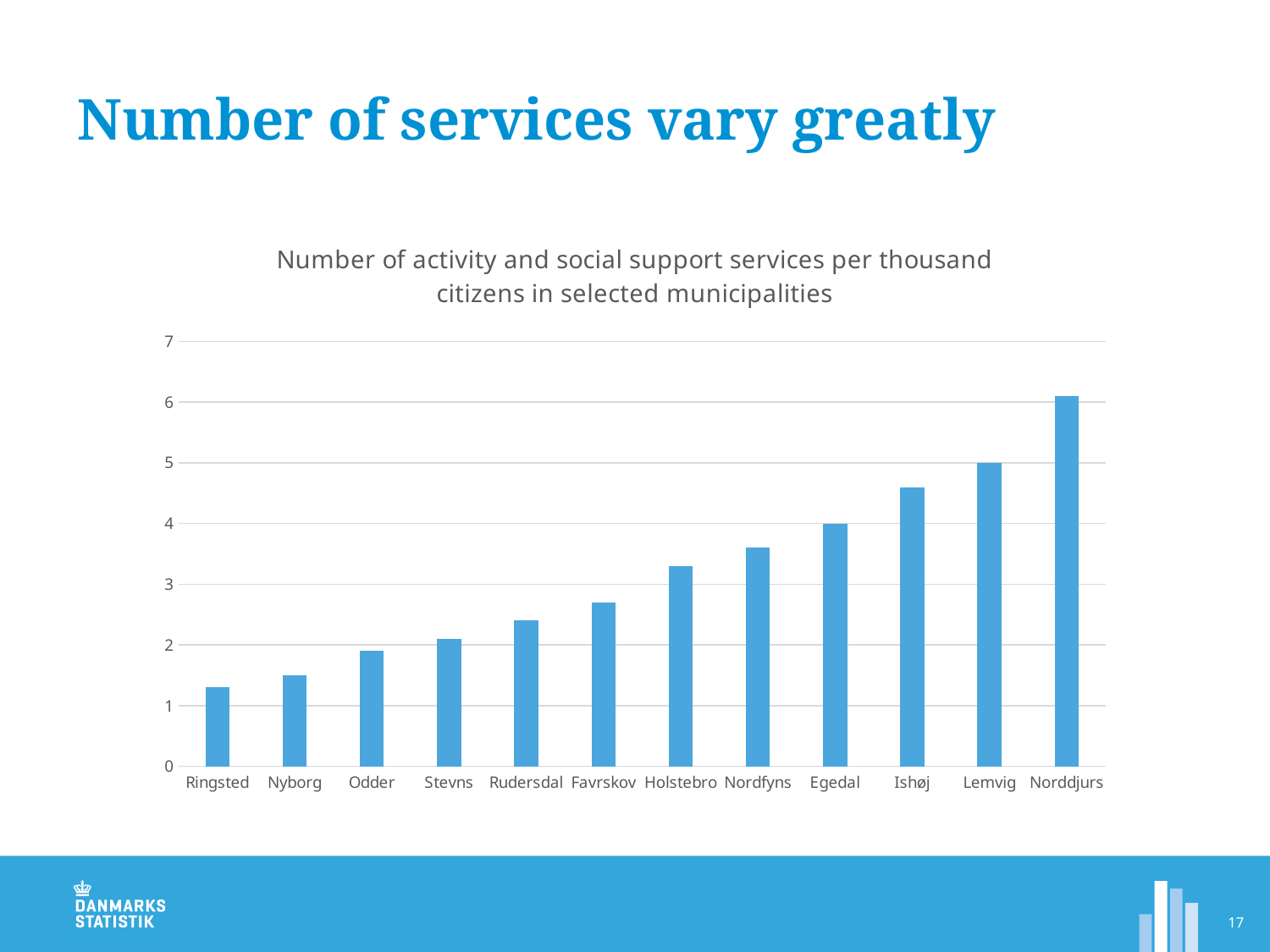
Which municipality has the lowest number of activity and social support services per thousand citizens? Ringsted What kind of chart is shown on the slide? Bar chart Is the value for Ringsted greater or less than 2? less Is the value for Ishøj greater or less than 4? greater What is the title of the chart? Number of activity and social support services per thousand citizens in selected municipalities Is the value for Holstebro greater or less than 3? greater Do the values rise or fall from left to right across the municipalities? Rise Which has a higher value, Lemvig or Norddjurs? Norddjurs How many municipalities are shown on the chart? 12 Which municipality has the highest number of activity and social support services per thousand citizens? Norddjurs